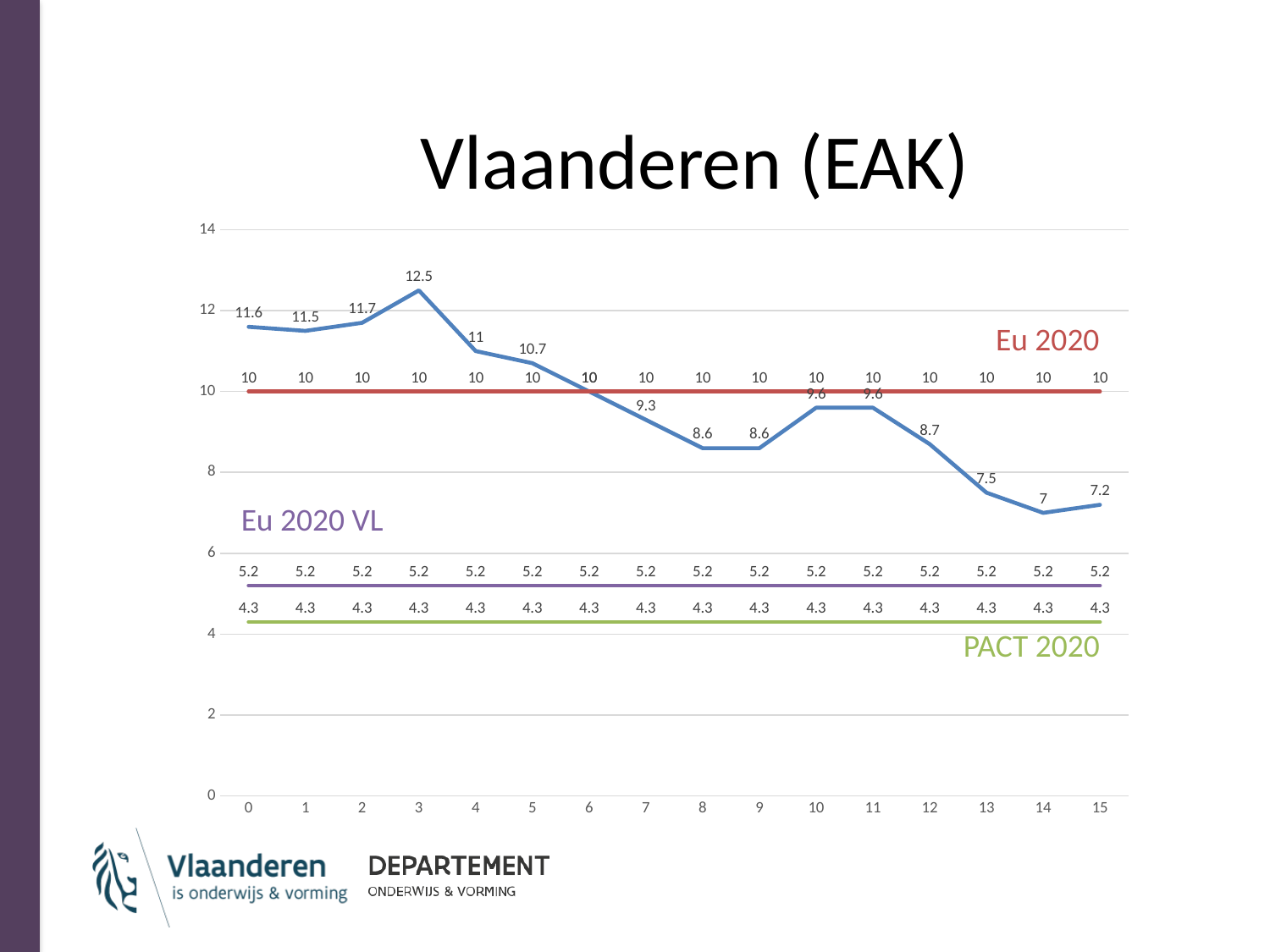
Which is larger: the Eu 2020 VL value or the PACT 2020 value? Eu 2020 VL How many x-axis points are plotted for the blue line? 16 What constant value does the PACT 2020 line have? 4.3 What is the difference between the blue line's value at x = 3 and at x = 14? 5.5 At which x value does the blue line reach its highest point? 3 What constant value does the Eu 2020 line have? 10 What is the title of the chart? Vlaanderen (EAK) What is the value of the blue line at x = 3? 12.5 At which x value does the blue line reach its lowest point? 14 What kind of chart is shown on the slide? line chart Does the blue line generally rise or fall from x = 3 to x = 14? fall What is the value of the blue line at x = 14? 7